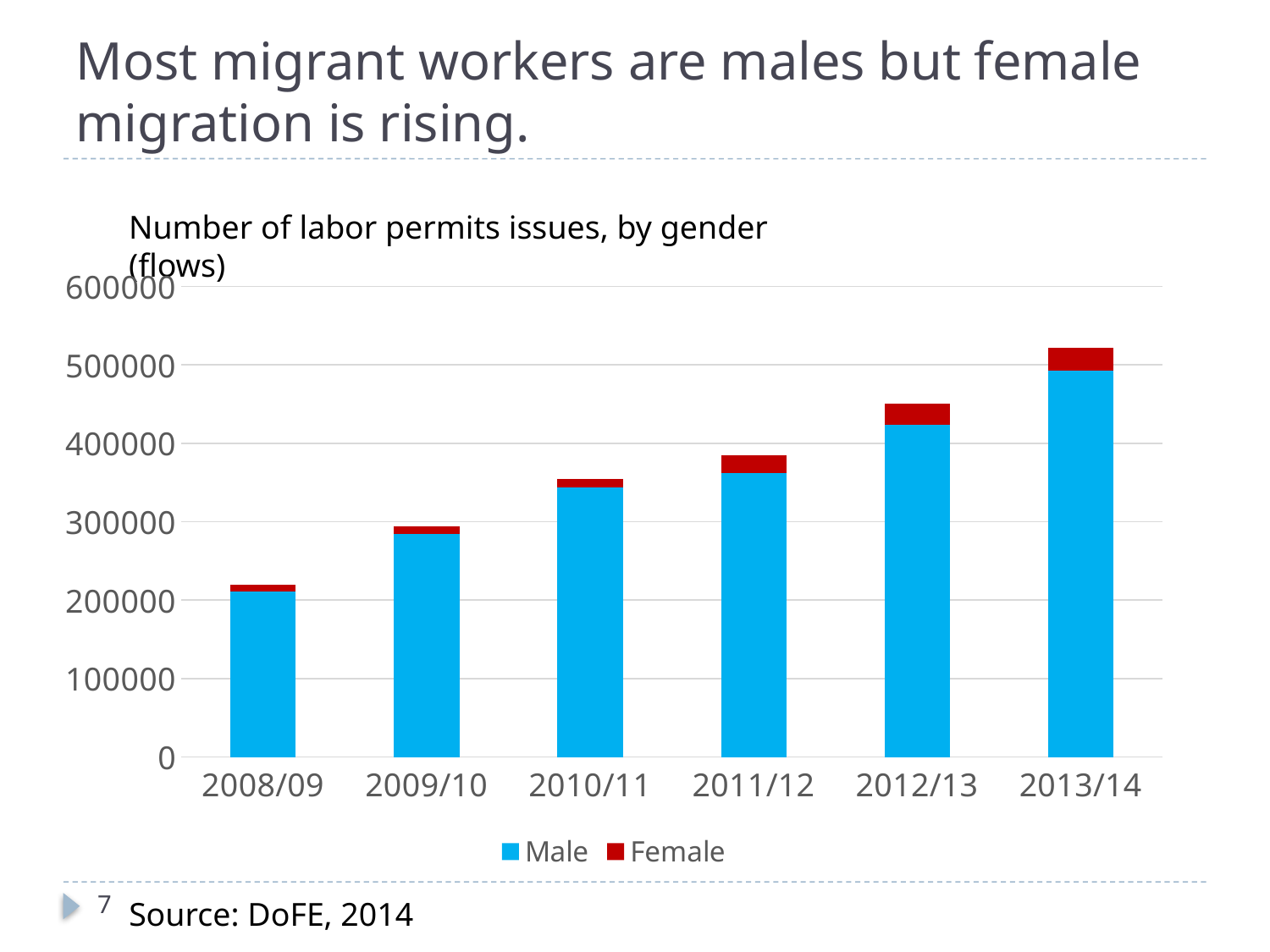
How many fiscal years are shown on the x axis? 6 Is the Male value for 2013/14 greater or less than 400000? greater Is the total number of labor permits in 2008/09 greater or less than 300000? less Which series is larger in 2011/12, Male or Female? Male How many series does the legend list? 2 Which year has the lowest total number of labor permits issued? 2008/09 What colour represents the Female series in the chart? Red Is the total number of labor permits in 2012/13 greater or less than 400000? greater Do the total number of labor permits rise or fall from 2008/09 to 2013/14? Rise Which year has the highest total number of labor permits issued? 2013/14 What kind of chart is shown on the slide? Stacked bar chart